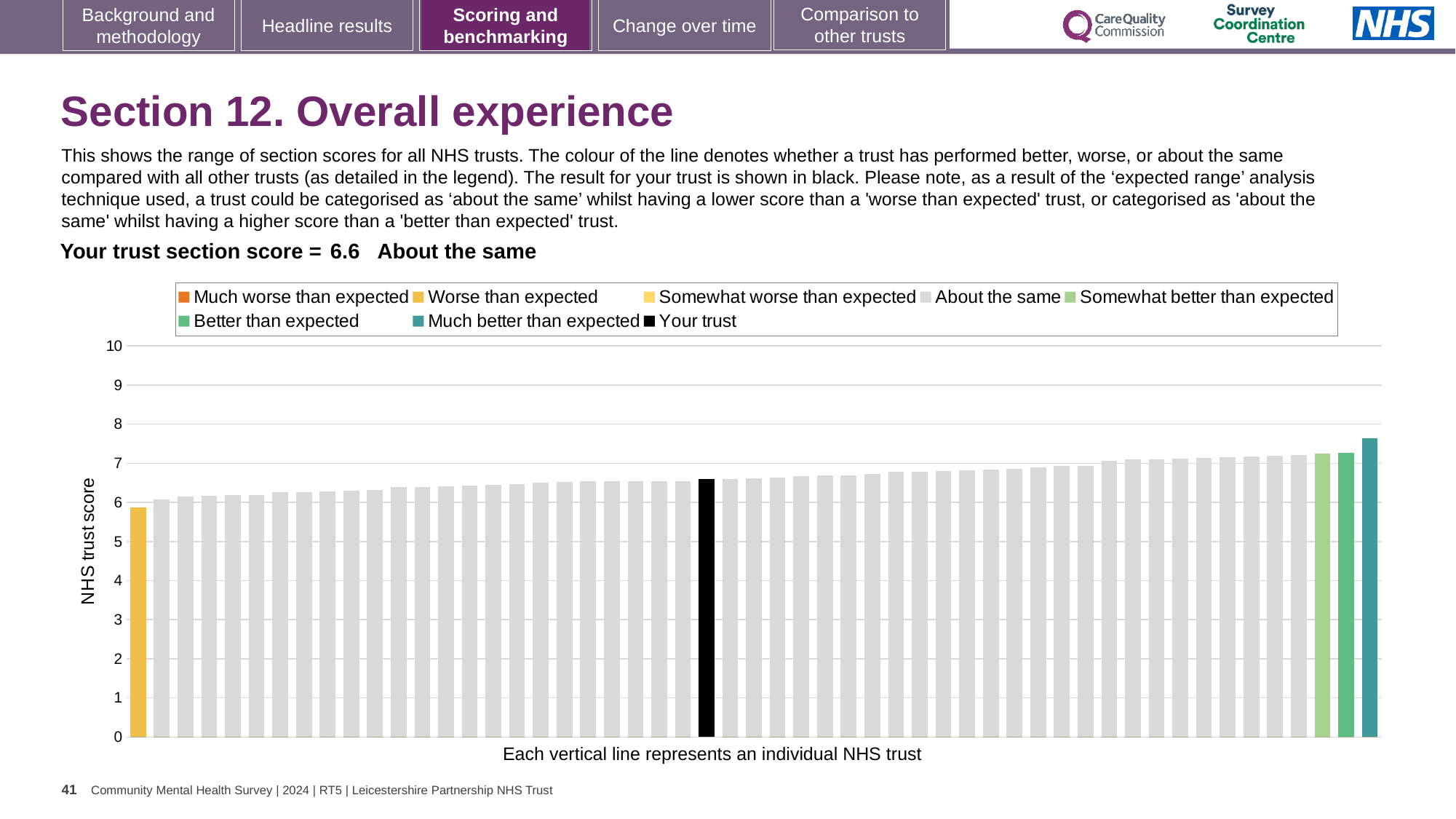
What kind of chart is shown on the slide? bar chart Is the value for the shortest bar (Worse than expected) greater or less than 5? greater Is the value for your trust (the black bar) greater or less than 7? less How many entries does the chart legend list? 8 How is your trust's score categorised compared with other trusts? About the same Which legend category does the highest bar on the chart belong to? Much better than expected Which legend category does the lowest bar on the chart belong to? Worse than expected Is the value for the tallest bar (Much better than expected) greater or less than 7? greater Do the bar values rise or fall from left to right along the x axis? rise What is the label on the vertical axis of the chart? NHS trust score How many bars are coloured as 'Somewhat better than expected'? 1 What is the section score for your trust shown on the slide? 6.6